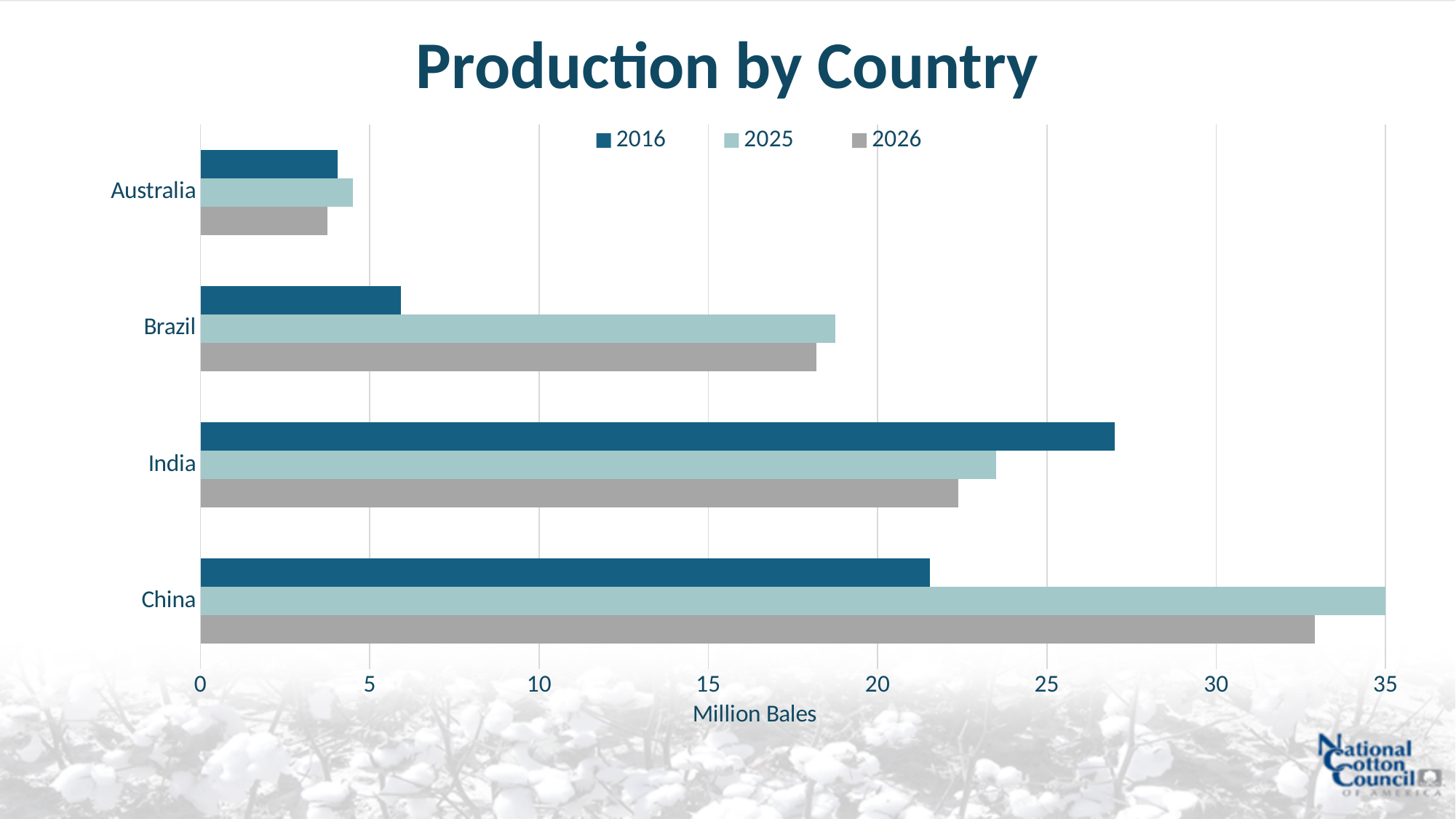
In the 2016 series, which is larger: India or China? India What kind of chart is shown on the slide? bar chart Is the 2026 value for Australia greater or less than 5? less How many series does the legend list? 3 What is the label on the horizontal axis? Million Bales Is the 2016 value for China greater or less than 20? greater Which country has the highest production in the 2025 series? China For Brazil, which series has the larger value: 2016 or 2025? 2025 Which country has the highest production in the 2016 series? India Which country has the lowest production in the 2026 series? Australia How many countries are shown on the chart? 4 Is the 2025 value for Brazil greater or less than 15? greater